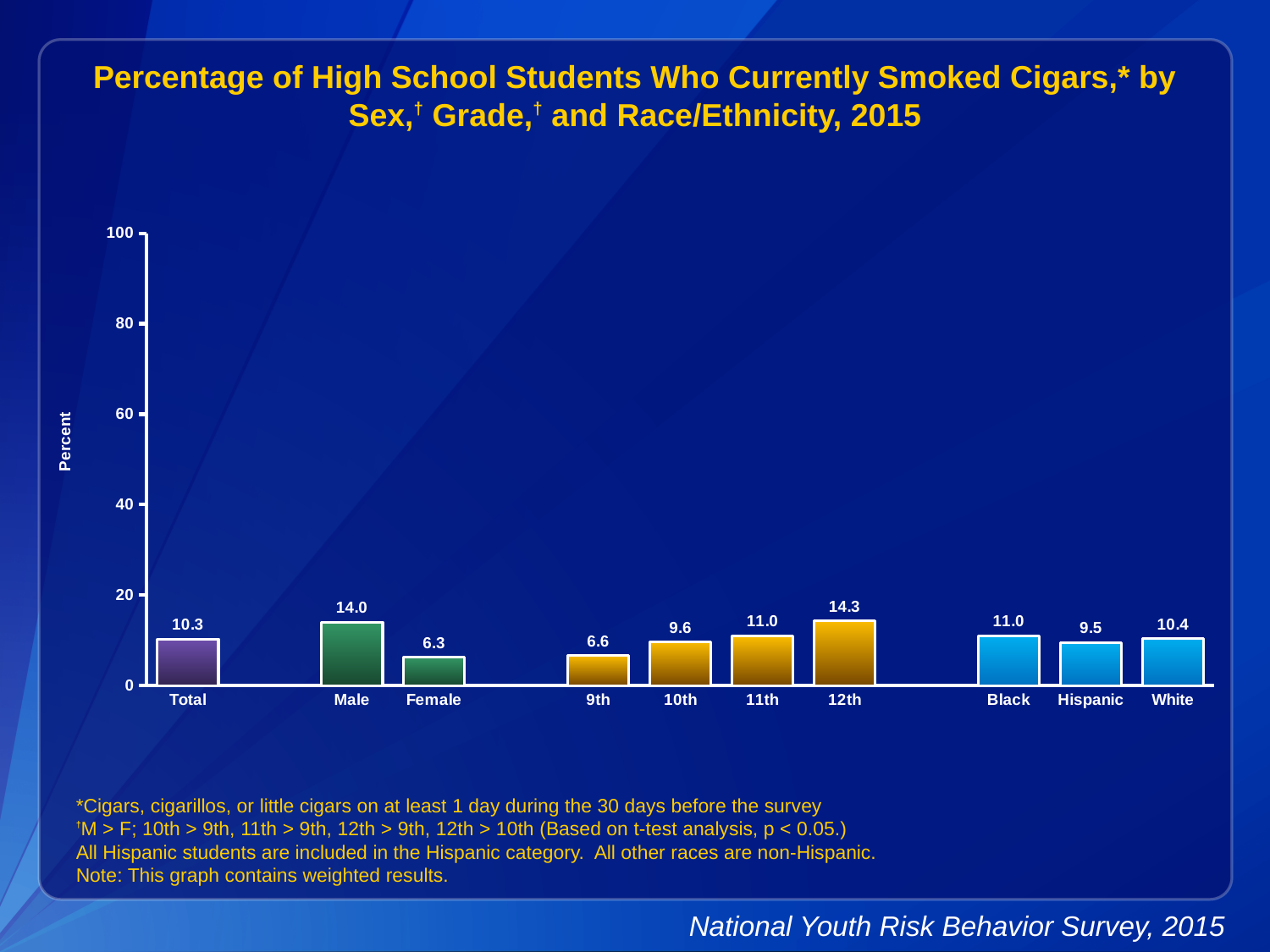
What is the label on the y axis? Percent How many categories are shown on the x axis? 10 Do the values rise or fall from 9th grade to 12th grade? Rise Which category has the lowest value? Female What is the value for Hispanic? 9.5 What is the value for Female? 6.3 Which category has the highest value? 12th Which is larger, the value for 9th grade or the value for 10th grade? 10th What is the difference between the Male and Female values? 7.7 What is the value for Total? 10.3 What is the value for 12th grade? 14.3 What kind of chart is this? Bar chart